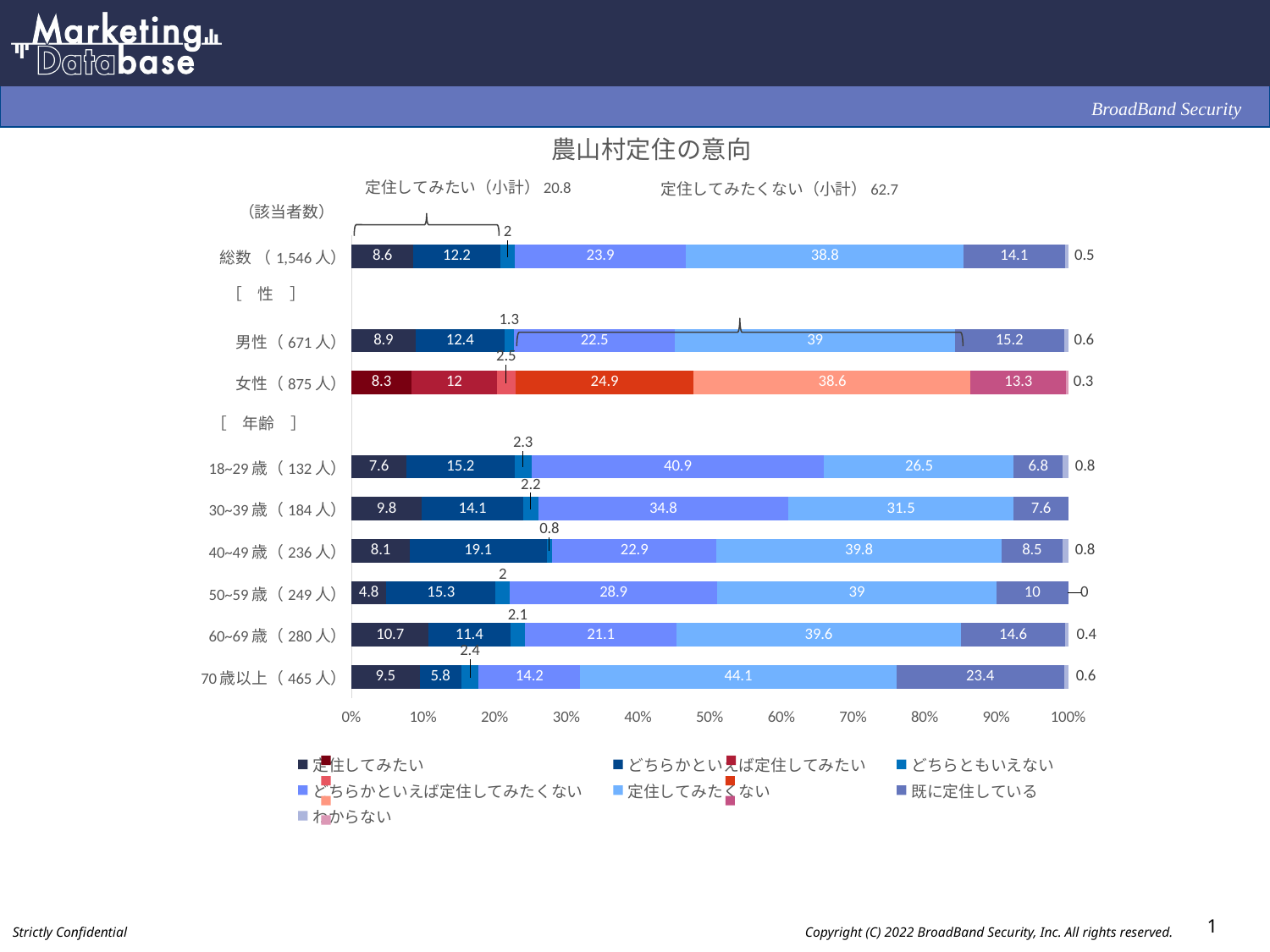
What is the value of 既に定住している for 70歳以上? 23.4 What is the value of 定住してみたくない for 総数? 38.8 What is the difference between the 定住してみたくない values for 70歳以上 and 18~29歳? 17.6 Which age group has the highest value for どちらかといえば定住してみたくない? 18~29歳 What is the number of respondents (該当者数) for 40~49歳? 236人 What is the value of 定住してみたい for 60~69歳? 10.7 How many series does the legend list? 7 How many category bars are plotted in the chart? 9 What kind of chart is shown on the slide? Stacked bar chart What is the 定住してみたい (小計) value shown above the chart? 20.8 Which age group has the lowest value for 定住してみたい? 50~59歳 Which is larger, the どちらかといえば定住してみたい value for 男性 or for 女性? 男性